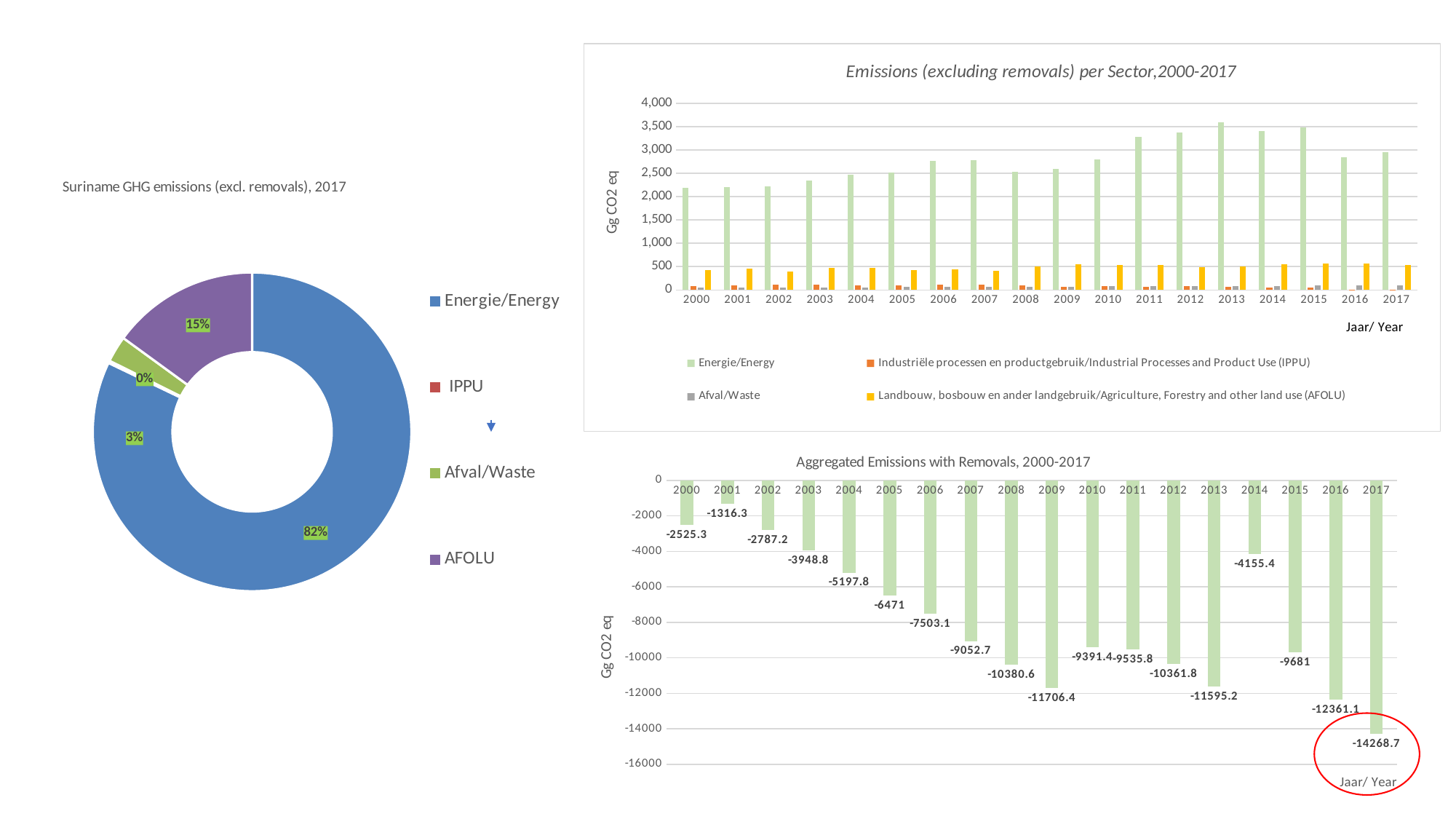
In the pie chart 'Suriname GHG emissions (excl. removals), 2017', what share does Energie/Energy have? 82% In the chart 'Aggregated Emissions with Removals, 2000-2017', what is the difference between the values for 2016 and 2017? 1907.6 In the chart 'Aggregated Emissions with Removals, 2000-2017', what is the value for 2014? -4155.4 In the chart 'Aggregated Emissions with Removals, 2000-2017', what is the value for 2017? -14268.7 In the chart 'Emissions (excluding removals) per Sector,2000-2017', which sector has the highest emissions in every year? Energie/Energy In the chart 'Emissions (excluding removals) per Sector,2000-2017', is the AFOLU value for 2000 greater or less than 500? less In the pie chart 'Suriname GHG emissions (excl. removals), 2017', what share does AFOLU have? 15% What kind of chart is 'Aggregated Emissions with Removals, 2000-2017'? bar chart In the chart 'Emissions (excluding removals) per Sector,2000-2017', how many series does the legend list? 4 In the chart 'Emissions (excluding removals) per Sector,2000-2017', is the Energie/Energy value for 2011 greater or less than 3,000? greater In the pie chart 'Suriname GHG emissions (excl. removals), 2017', how many categories does the legend list? 4 In the pie chart 'Suriname GHG emissions (excl. removals), 2017', which category has the largest share? Energie/Energy